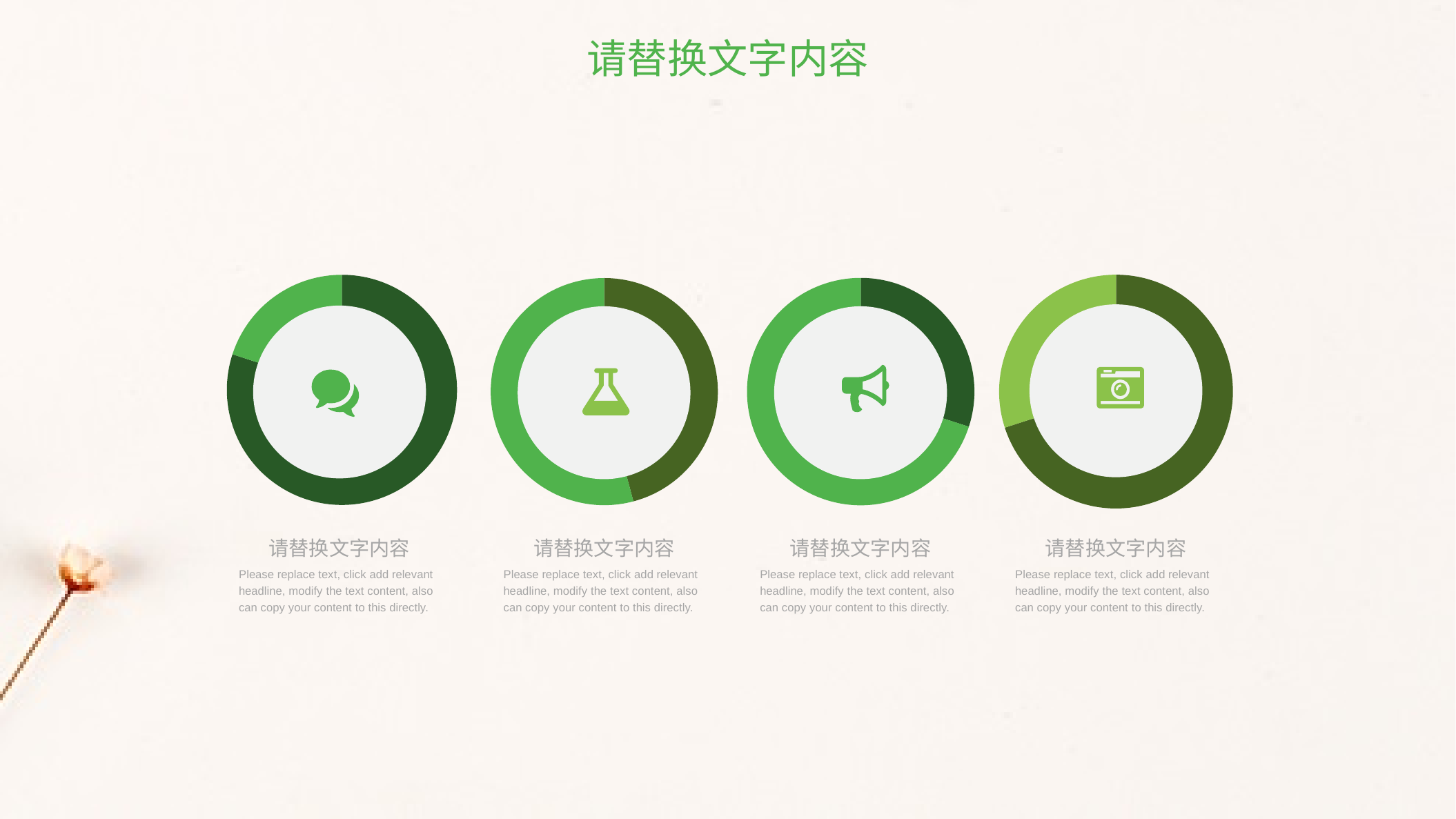
What kind of chart is shown in each of the four circles on the slide? Donut chart How many donut charts are on the slide? 4 How many segments does the leftmost donut chart have? 2 In the third donut chart from the left, which segment is larger, the light green one or the dark green one? Light green In the rightmost donut chart, which segment is larger, the dark olive one or the light green one? Dark olive What icon is shown in the centre of the rightmost donut chart? A camera How many segments does the rightmost donut chart have? 2 What icon is shown in the centre of the second donut chart from the left? A flask In the second donut chart from the left, which segment is larger, the light green one or the dark olive one? Light green